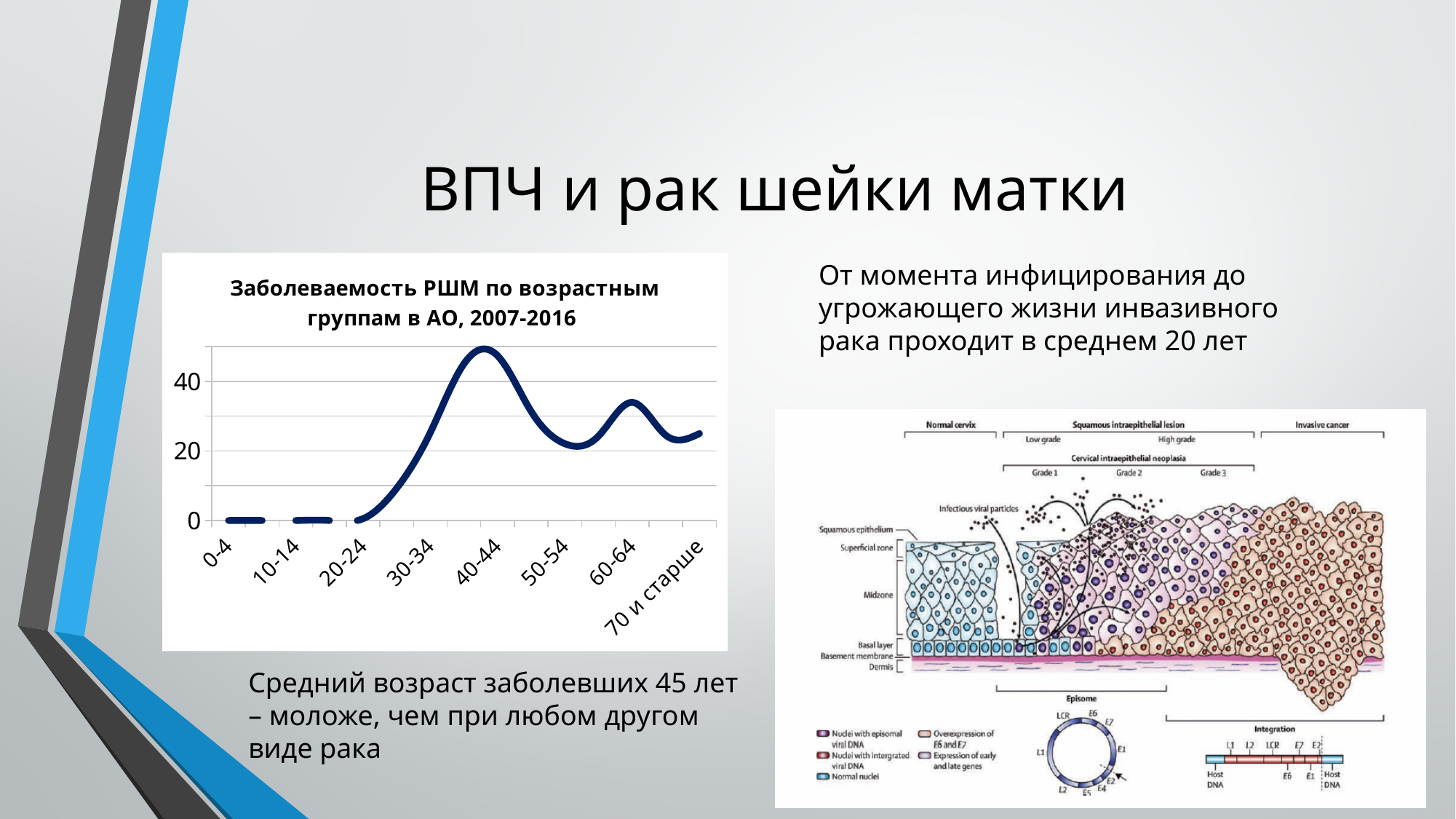
Which is larger, the value for 50-54 or the value for 60-64? 60-64 Is the value for the 60-64 age group greater or less than 20? greater Is the value for the 40-44 age group greater or less than 40? greater What is the title of the chart on the slide? Заболеваемость РШМ по возрастным группам в АО, 2007-2016 What is the value for the 0-4 age group? 0 Does the line rise or fall between the 20-24 and 40-44 age groups? rise Is the value for the 60-64 age group greater or less than 40? less What kind of chart is shown on the slide? line chart Which is larger, the value for 40-44 or the value for 60-64? 40-44 Which age group has the highest incidence in the chart? 40-44